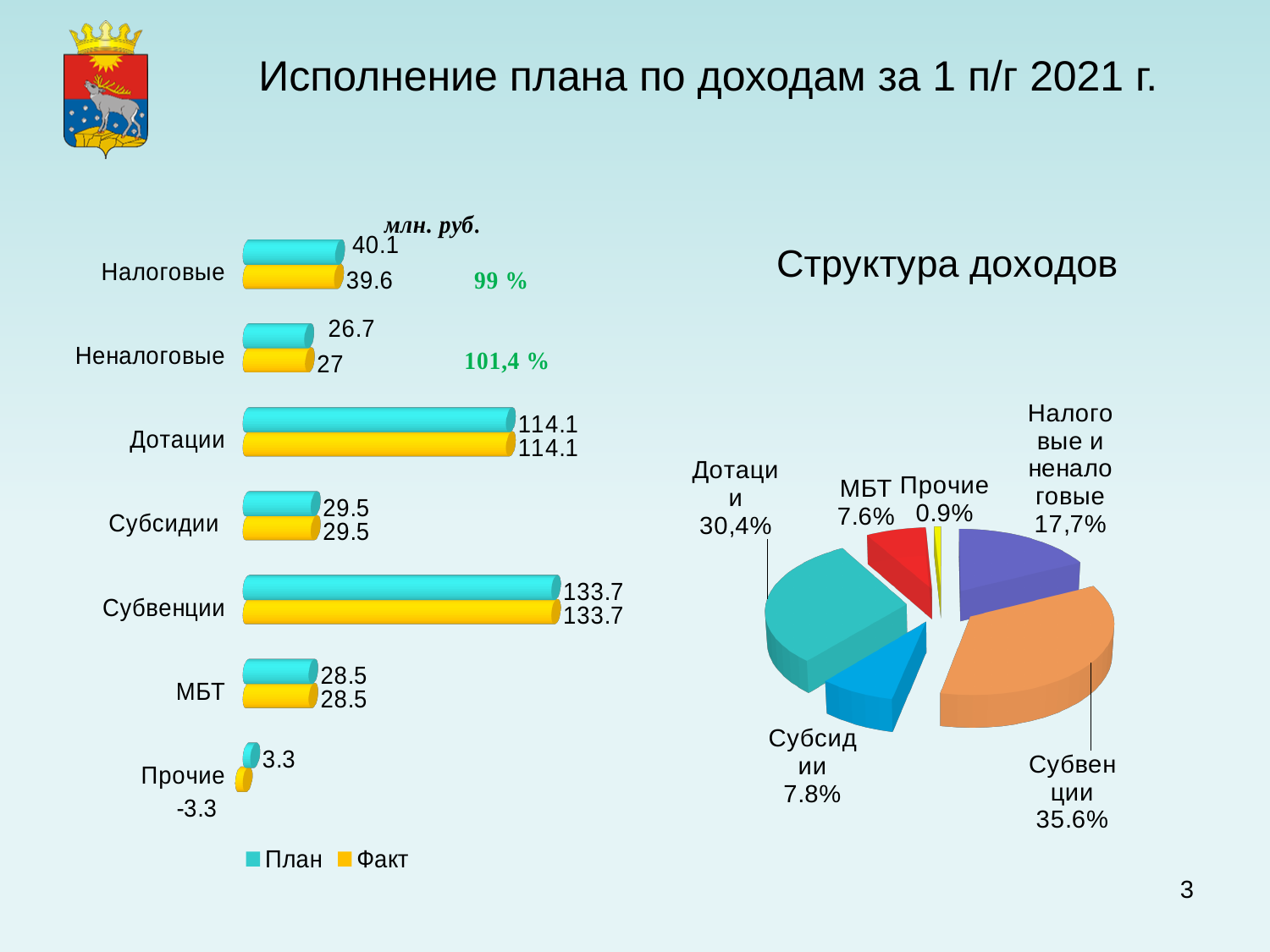
In the left bar chart, what is the Факт value for Налоговые? 39.6 In the left bar chart, which category has the lowest Факт value? Прочие How many series does the legend of the left bar chart list? 2 How many categories are shown in the left bar chart? 7 In the left bar chart, which category has the highest План value? Субвенции What type of chart is the chart on the left of the slide? Bar chart In the pie chart Структура доходов, which slice is the smallest? Прочие In the pie chart Структура доходов, what share do Субвенции have? 35.6% In the left bar chart, which is larger for Неналоговые: План or Факт? Факт In the left bar chart, what is the План value for Субвенции? 133.7 In the left bar chart, what is the Факт value for Прочие? -3.3 In the left bar chart, what is the difference between the План and Факт values for Налоговые? 0.5